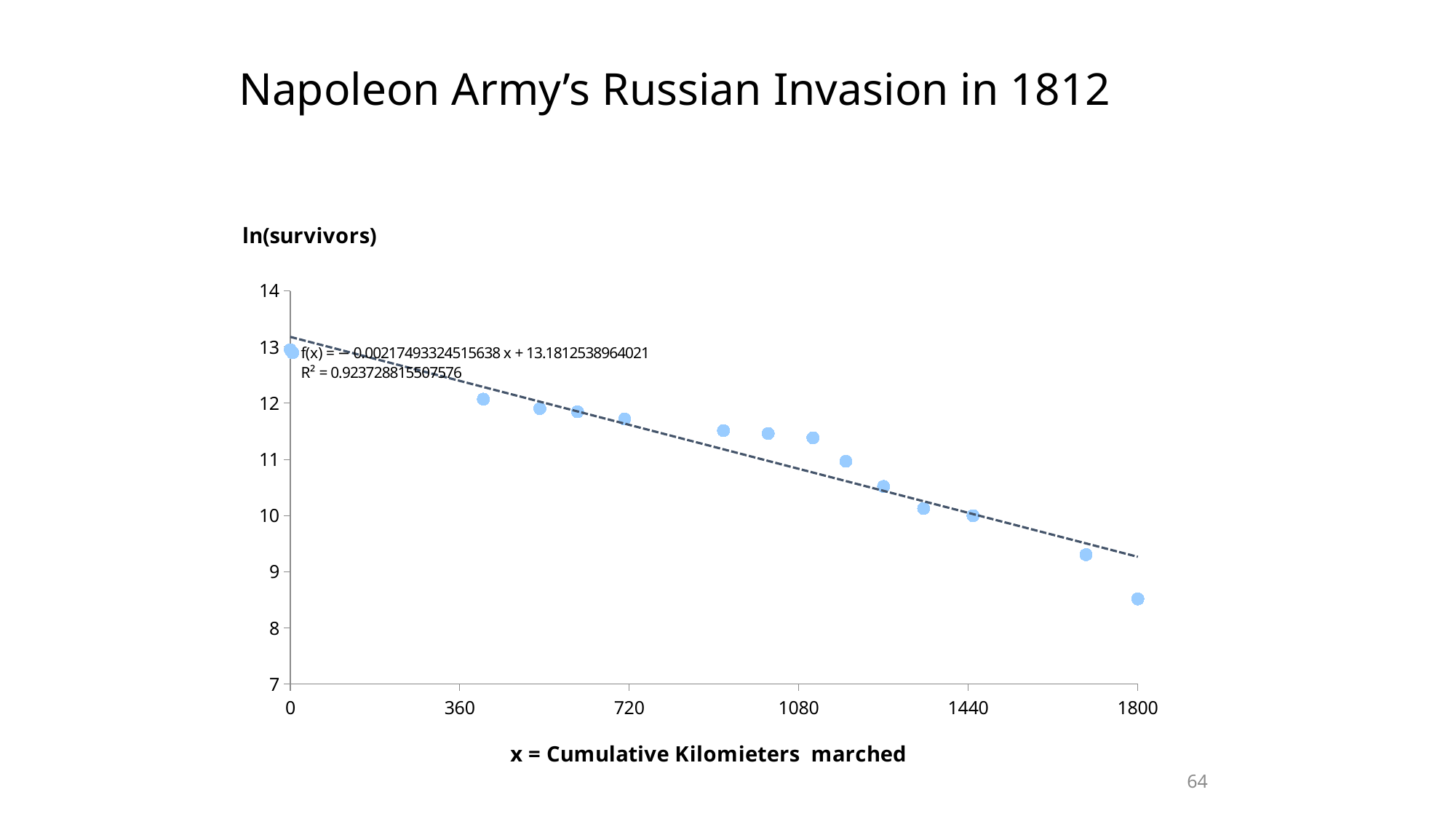
Which point has the highest ln(survivors) value, the one at x = 0 or the one at x = 1800? x = 0 Is the ln(survivors) value of the point just past x = 1080 greater or less than 11? greater Do the plotted ln(survivors) values rise or fall as cumulative kilometers marched increases? fall Is the ln(survivors) value at x = 0 greater or less than 12? greater At which x value is the lowest ln(survivors) point plotted? 1800 What is the R² value shown for the trendline? 0.923728815507576 Is the ln(survivors) value at x = 1800 greater or less than 9? less At which x value is the highest ln(survivors) point plotted? 0 What kind of chart is shown on the slide? scatter chart What is the label of the vertical axis? ln(survivors) How many data points are plotted on the chart? 15